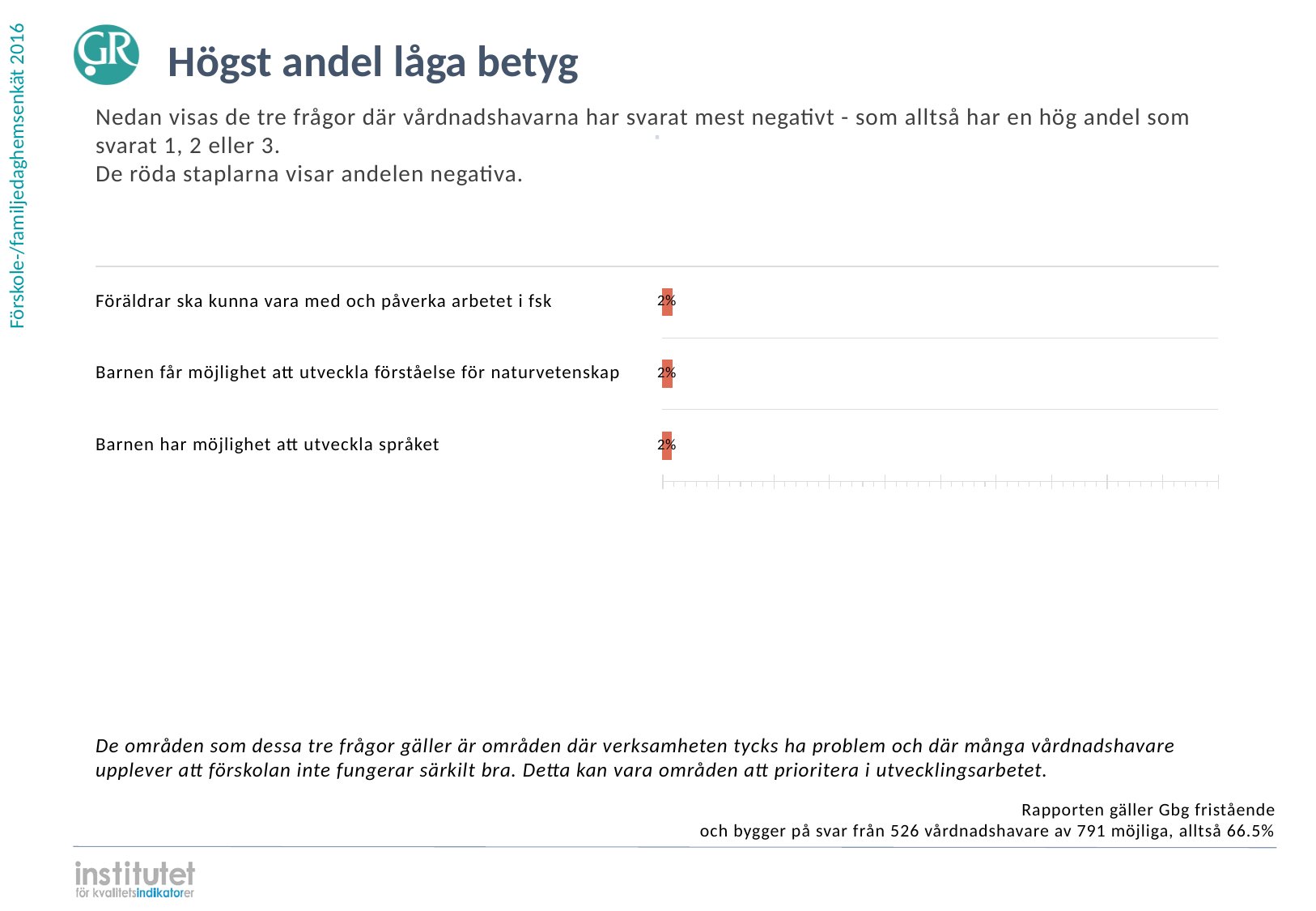
What is the title of the slide containing the chart? Högst andel låga betyg What is the difference between the value for "Barnen har möjlighet att utveckla språket" and the value for "Föräldrar ska kunna vara med och påverka arbetet i fsk"? 0% How many categories (questions) are plotted in the chart? 3 Do all three categories in the chart show the same value? Yes What kind of chart is shown on the slide? Bar chart What is the value shown for "Föräldrar ska kunna vara med och påverka arbetet i fsk"? 2% What colour are the bars in the chart? Red What is the value shown for "Barnen får möjlighet att utveckla förståelse för naturvetenskap"? 2% What is the value shown for "Barnen har möjlighet att utveckla språket"? 2%